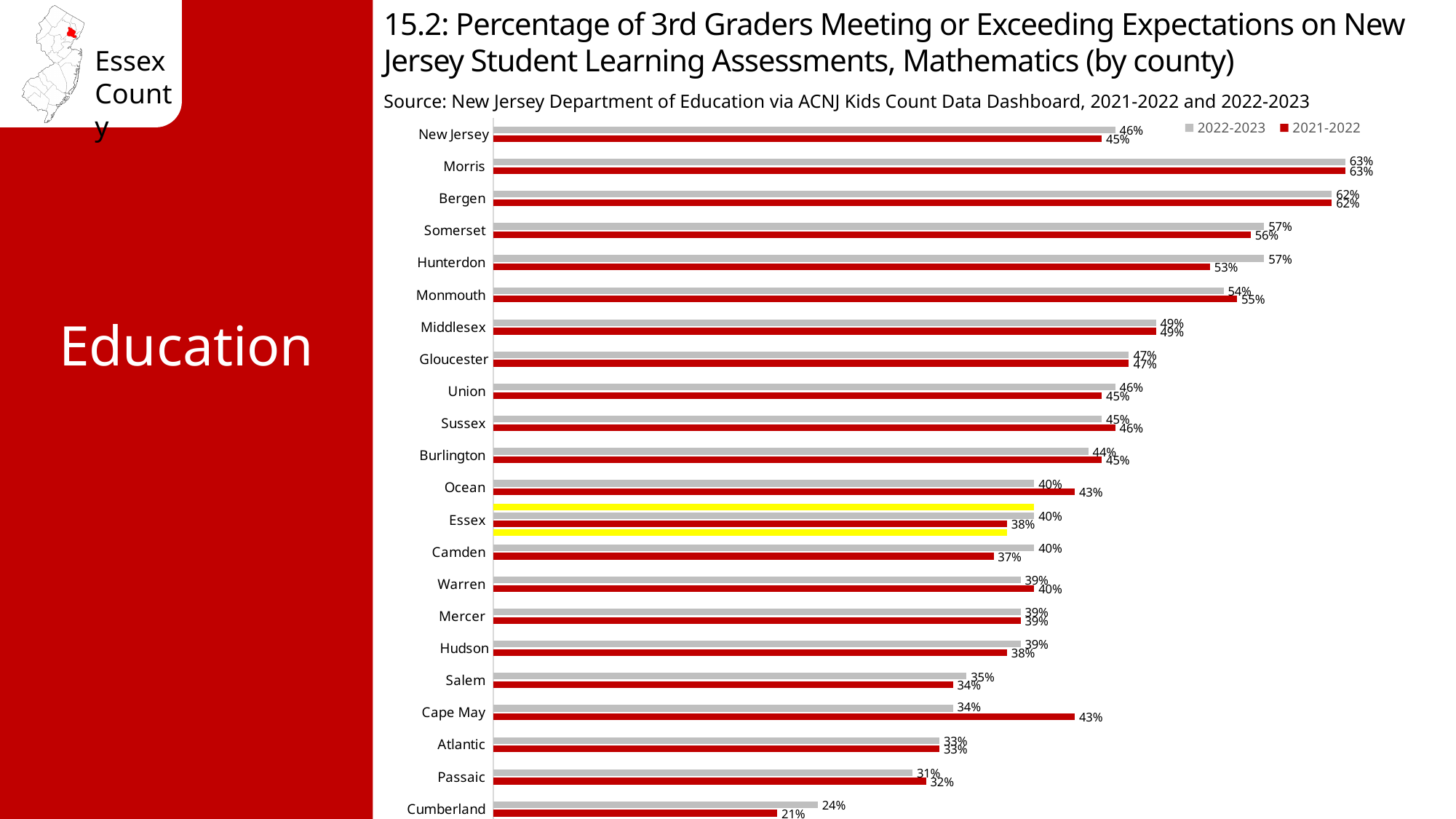
What was the 2022-2023 value for Hunterdon? 57% How many series does the legend list? 2 What percentage of 3rd graders in Essex met or exceeded expectations in mathematics in 2022-2023? 40% What is the difference between the 2022-2023 and 2021-2022 values for Hunterdon? 4 percentage points What was the 2021-2022 value for Cape May? 43% What type of chart is shown on the slide? Bar chart Which series is shown in red? 2021-2022 Which county has the highest 2022-2023 percentage? Morris What is the difference between Cape May's 2021-2022 and 2022-2023 values? 9 percentage points Which is larger for Ocean: the 2022-2023 value or the 2021-2022 value? 2021-2022 Which county has the lowest 2021-2022 percentage? Cumberland How many categories (counties plus New Jersey) are shown on the chart? 22